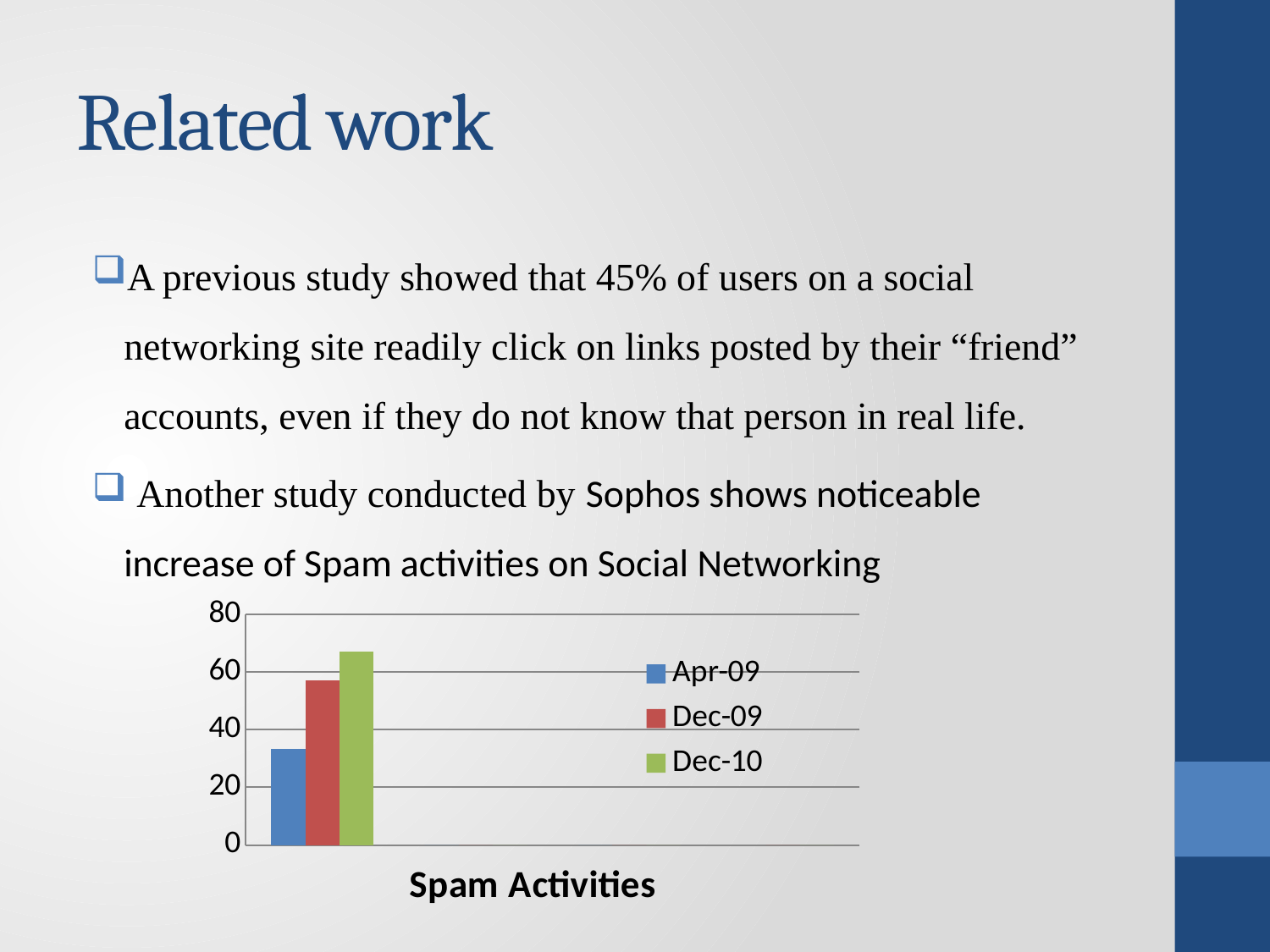
Which series has the lowest bar in the Spam Activities chart? Apr-09 Is the bar for Dec-09 greater or less than 40? greater Is the bar for Apr-09 greater or less than 20? greater Is the bar for Dec-10 greater or less than 60? greater What is the category label shown below the chart's x axis? Spam Activities Which is larger, the bar for Apr-09 or the bar for Dec-09? Dec-09 Which is larger, the bar for Dec-09 or the bar for Dec-10? Dec-10 Which series is shown in green in the chart's legend? Dec-10 Which series has the highest bar in the Spam Activities chart? Dec-10 What kind of chart is shown on the slide? bar chart How many series does the legend of the chart list? 3